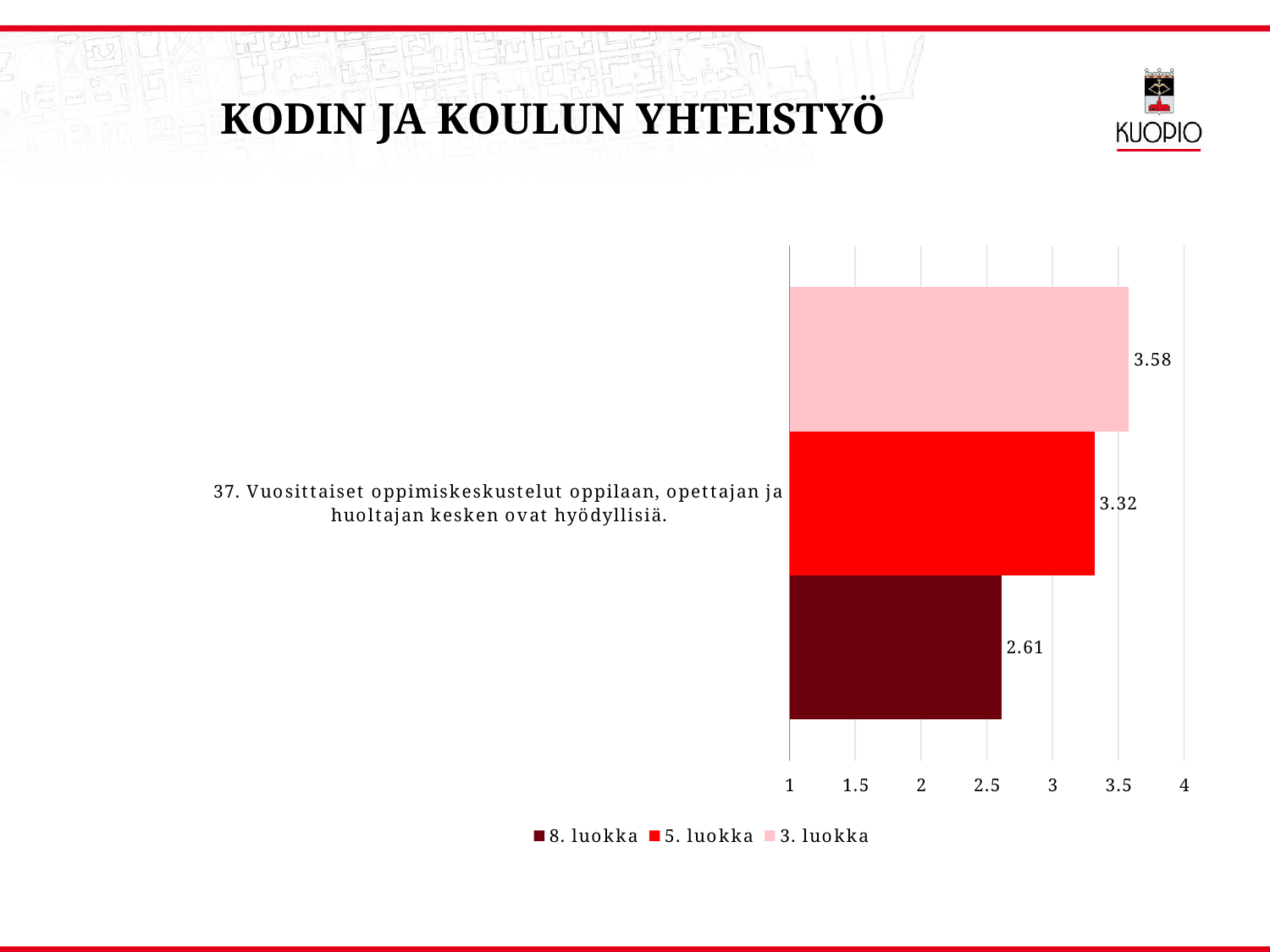
What is the difference between the values for 5. luokka and 8. luokka? 0.71 Which series has the highest value? 3. luokka What colour is the bar for 3. luokka? light pink What is the value for 8. luokka? 2.61 Which is larger, the value for 5. luokka or the value for 8. luokka? 5. luokka What is the value for 5. luokka? 3.32 What is the value for 3. luokka? 3.58 How many series does the legend list? 3 Is the value for 8. luokka greater or less than 3? less Which series has the lowest value? 8. luokka What is the difference between the values for 3. luokka and 8. luokka? 0.97 What kind of chart is shown on the slide? bar chart